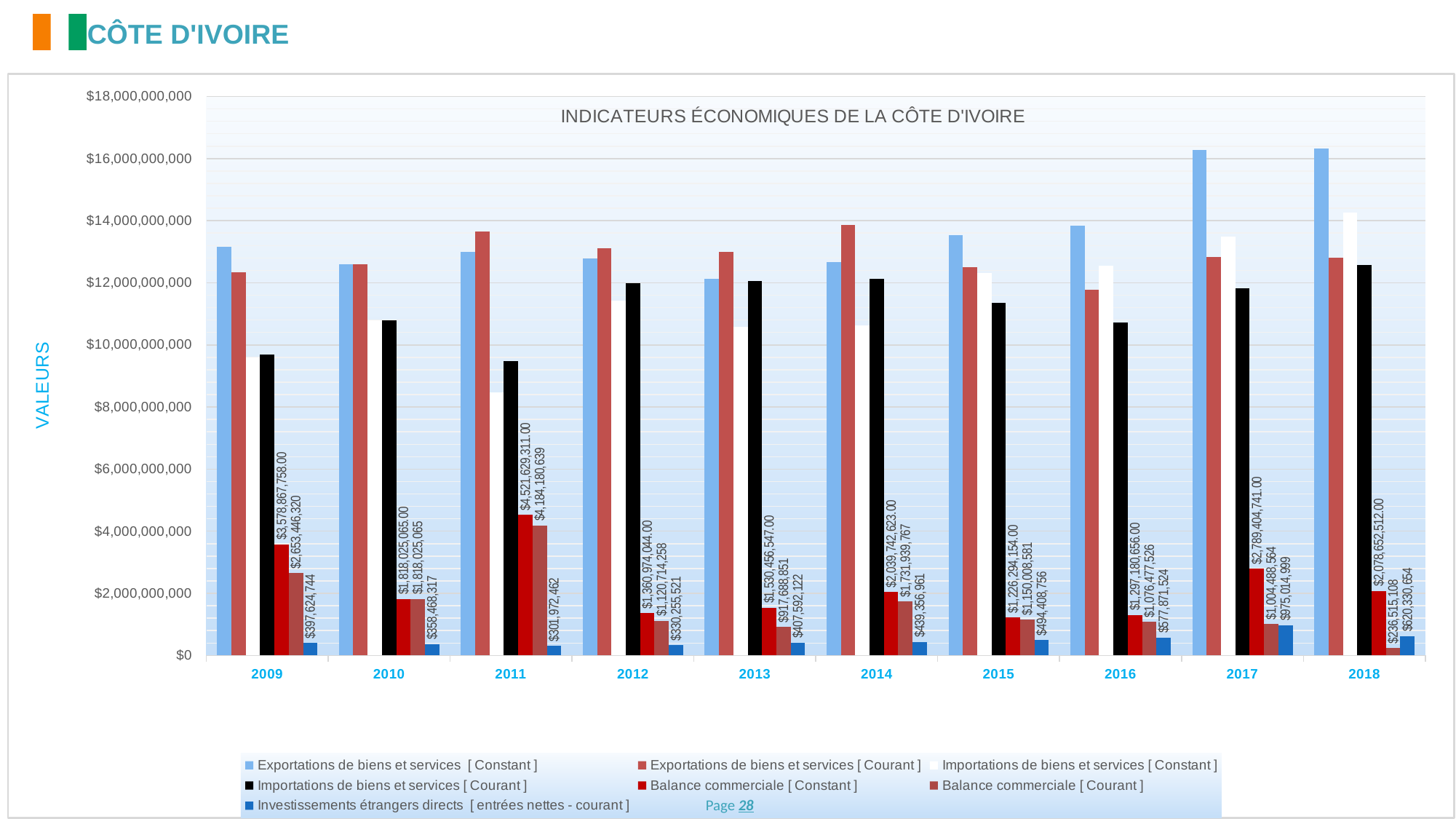
How many years are shown on the x axis of the chart? 10 In which year is Balance commerciale [ Courant ] lowest? 2018 What is the difference between Balance commerciale [ Constant ] and Balance commerciale [ Courant ] in 2009? $925,421,438 What is the value of Balance commerciale [ Constant ] in 2011? $4,521,629,311.00 Which is larger: Importations de biens et services [ Courant ] in 2009 or in 2010? 2010 What kind of chart is shown on the slide? bar chart In which year is Investissements étrangers directs [ entrées nettes - courant ] highest? 2017 What is the value of Balance commerciale [ Courant ] in 2014? $1,731,939,767 In which year is Balance commerciale [ Constant ] highest? 2011 Is the value for Exportations de biens et services [ Constant ] in 2017 greater or less than $16,000,000,000? greater What is the value of Investissements étrangers directs [ entrées nettes - courant ] in 2017? $975,014,999 How many series does the chart legend list? 7